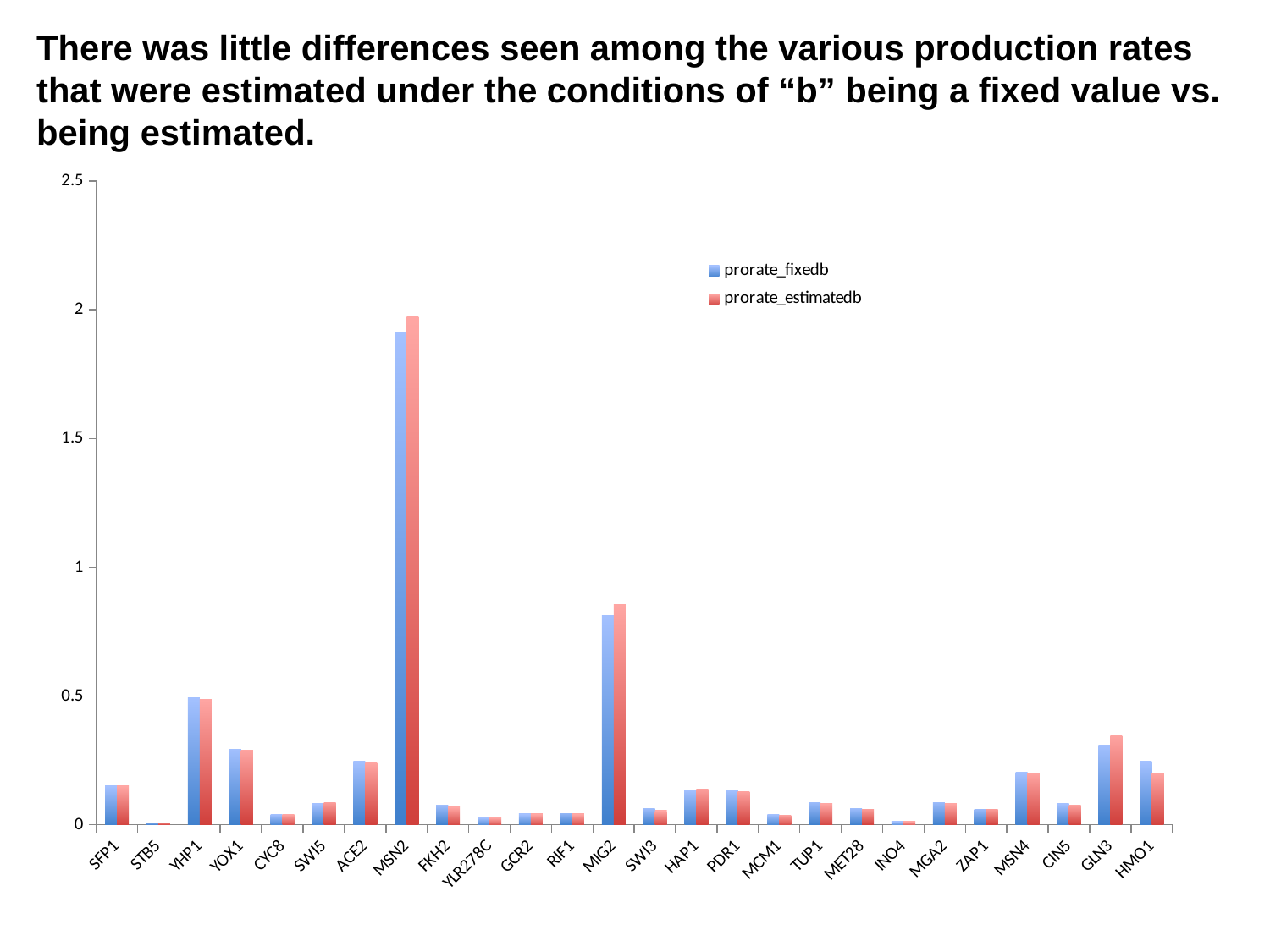
How many series does the legend list? 2 How many categories are shown along the x axis? 26 Which has a larger prorate_fixedb value, MSN2 or MIG2? MSN2 What kind of chart is shown on the slide? bar chart Is the prorate_fixedb value for MIG2 greater or less than 1? less Which category has the highest value for prorate_fixedb? MSN2 For HMO1, which series has the larger value, prorate_fixedb or prorate_estimatedb? prorate_fixedb Is the prorate_fixedb value for YHP1 greater or less than 1? less Is the prorate_estimatedb value for MSN2 greater or less than 1.5? greater What are the two series names listed in the legend? prorate_fixedb and prorate_estimatedb Which has a larger prorate_fixedb value, YHP1 or YOX1? YHP1 Which category has the highest value for prorate_estimatedb? MSN2